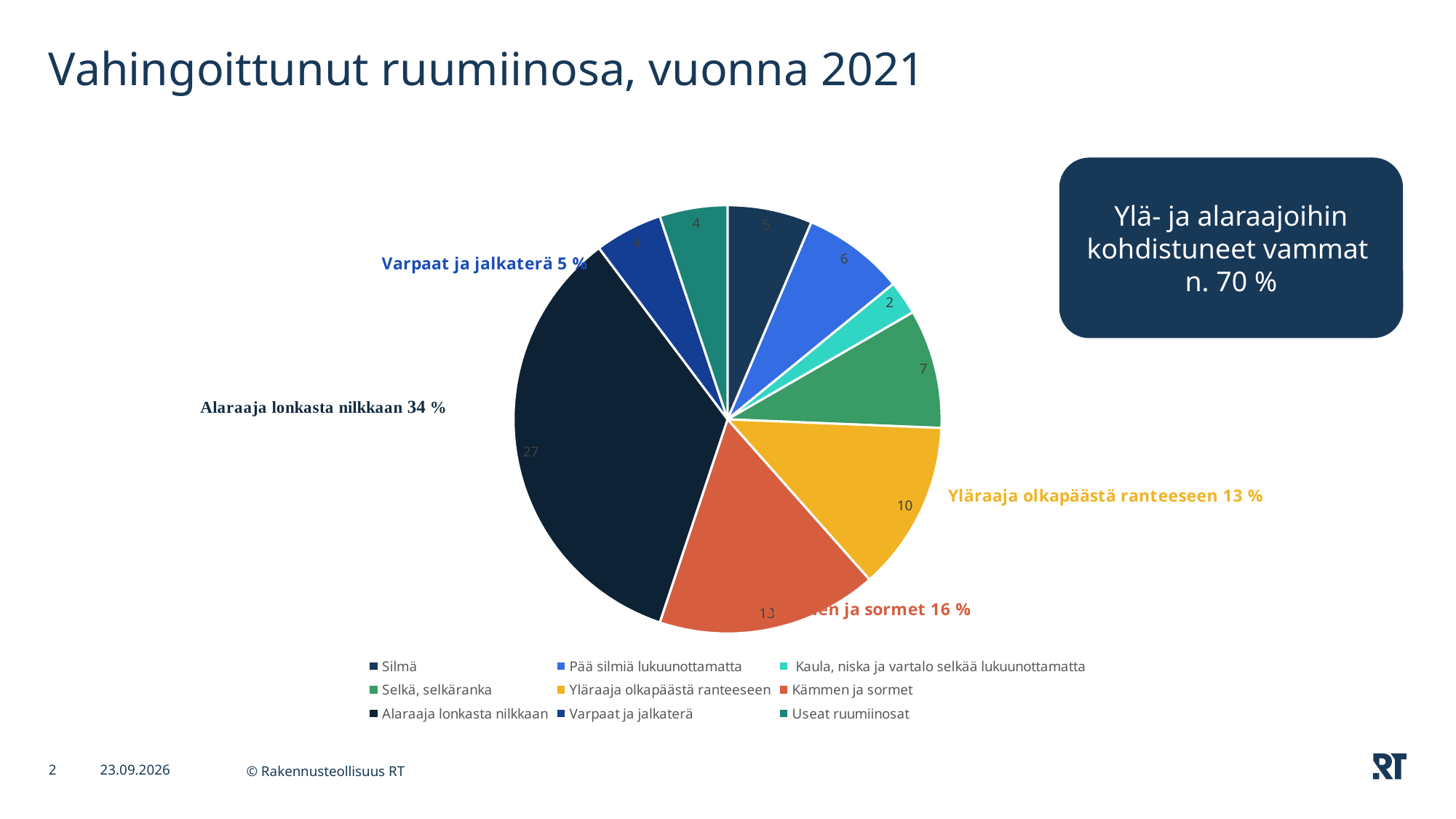
What is the difference between the values for Alaraaja lonkasta nilkkaan and Kämmen ja sormet? 14 What kind of chart is shown on the slide? pie chart What percentage share is printed on the slide for Alaraaja lonkasta nilkkaan? 34 % What is the value shown for Selkä, selkäranka? 7 What is the value shown for Yläraaja olkapäästä ranteeseen? 10 What is the value shown for Alaraaja lonkasta nilkkaan? 27 How many categories does the legend list? 9 What is the value shown for Kämmen ja sormet? 13 Which category has the largest slice of the pie? Alaraaja lonkasta nilkkaan Which is larger, the value for Silmä or the value for Pää silmiä lukuunottamatta? Pää silmiä lukuunottamatta Which category has the smallest slice of the pie? Kaula, niska ja vartalo selkää lukuunottamatta What is the value shown for Kaula, niska ja vartalo selkää lukuunottamatta? 2